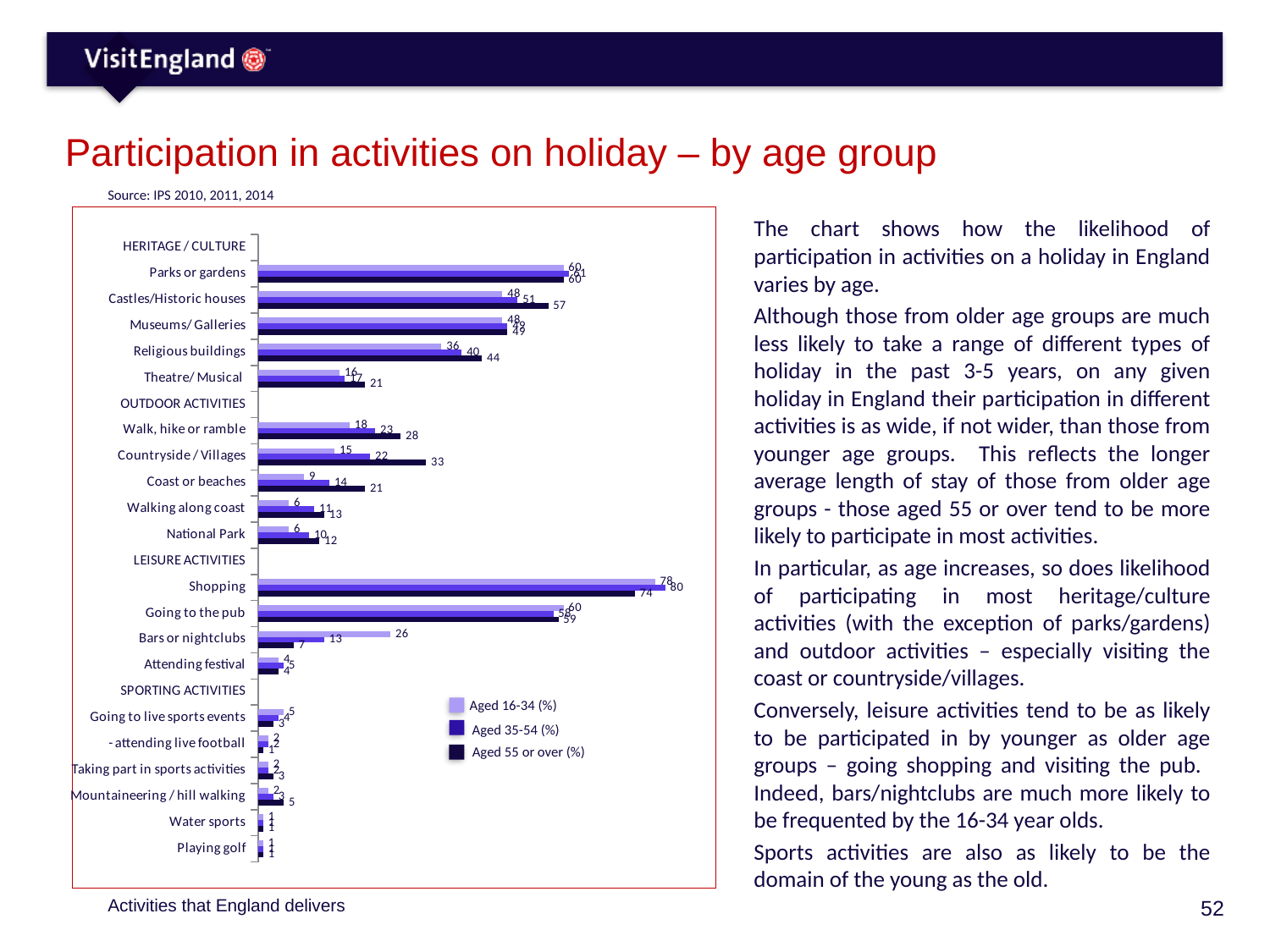
How many series does the legend list? 3 What is the value for Religious buildings for those aged 55 or over? 44 What is the value for Bars or nightclubs for those aged 16-34? 26 Which activity has the highest value for those aged 35-54? Shopping What is the value for Castles/Historic houses for those aged 55 or over? 57 What is the value for Shopping for those aged 35-54? 80 What kind of chart is shown on the slide? bar chart For Castles/Historic houses, which age group has the larger value: Aged 16-34 or Aged 55 or over? Aged 55 or over How many activities are listed under the OUTDOOR ACTIVITIES heading? 5 What is the source cited above the chart? IPS 2010, 2011, 2014 What is the value for Countryside / Villages for those aged 55 or over? 33 What is the difference between the Aged 16-34 and Aged 55 or over values for Bars or nightclubs? 19